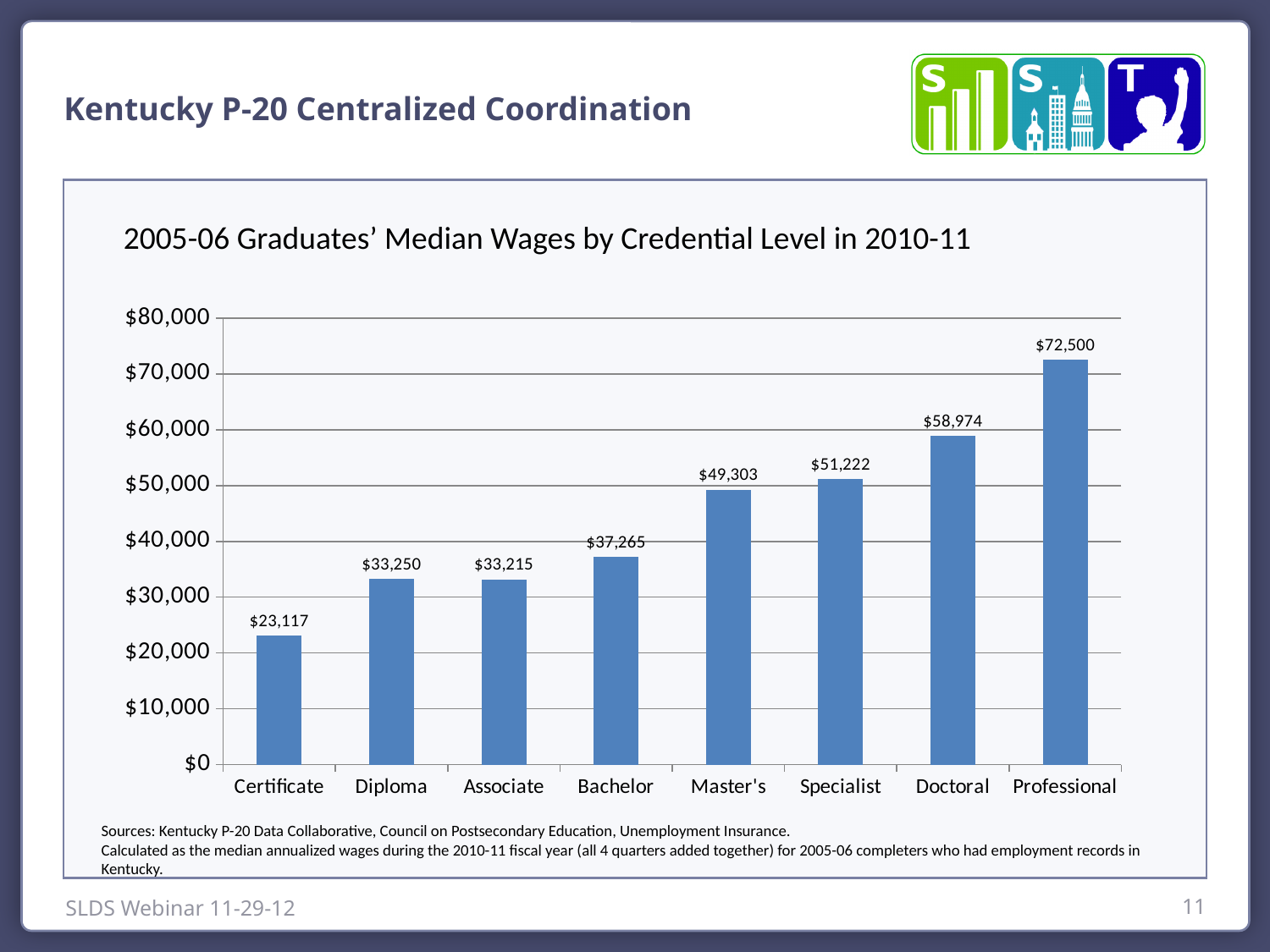
What kind of chart is shown on the slide? bar chart Is the median wage for Doctoral graduates greater or less than $60,000? less What is the median wage for Master's graduates? $49,303 What is the difference between the median wages for Professional and Certificate graduates? $49,383 Which credential level has the highest median wage? Professional What is the difference between the median wages for Doctoral and Master's graduates? $9,671 What is the median wage for Certificate graduates? $23,117 Which credential level has the lowest median wage? Certificate Which has a higher median wage, Specialist or Doctoral? Doctoral How many credential levels are shown on the chart? 8 What is the title of the chart? 2005-06 Graduates' Median Wages by Credential Level in 2010-11 What is the median wage for Bachelor graduates? $37,265